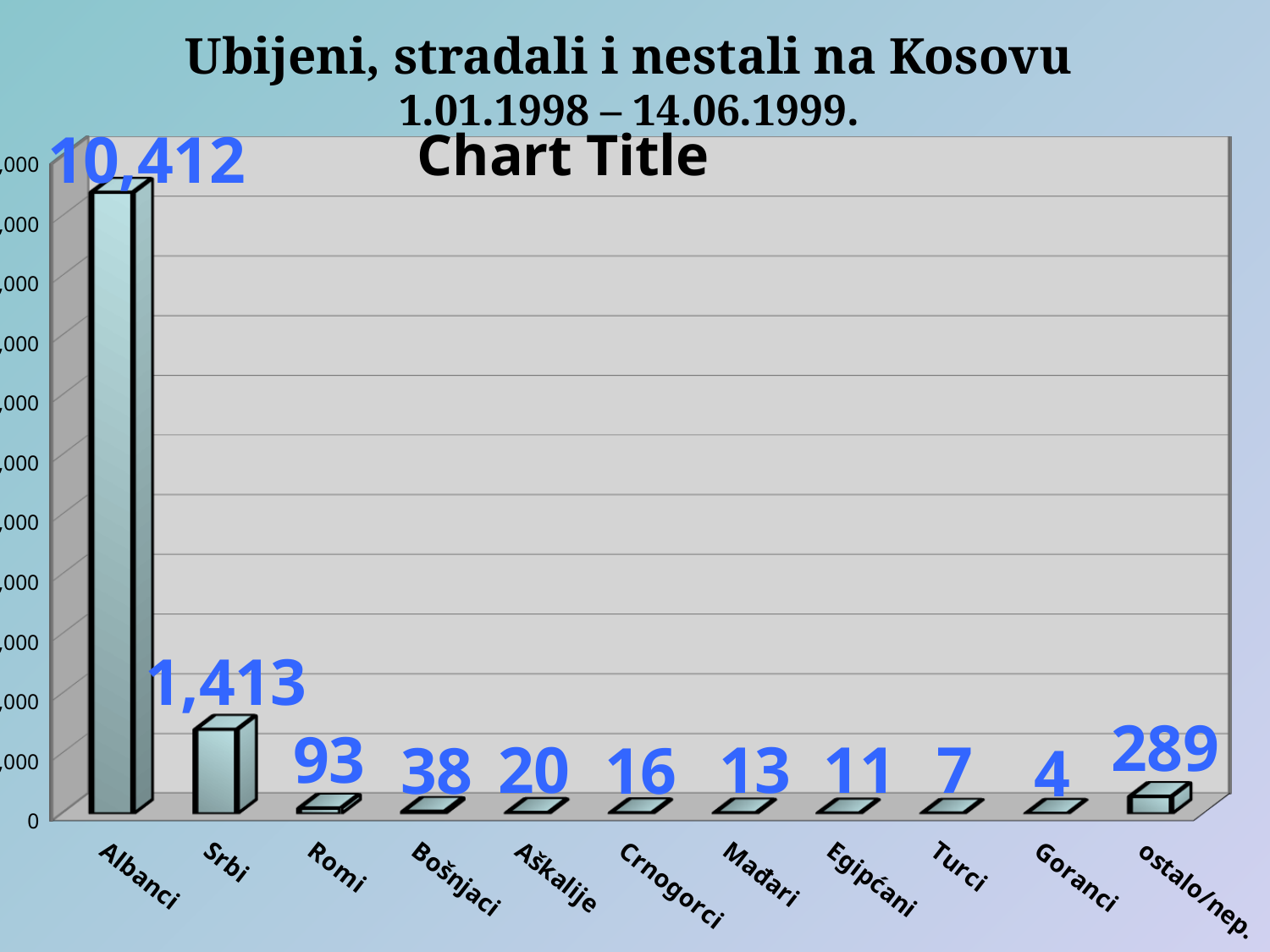
Which category has the lowest value? Goranci Which category has the highest value? Albanci How many categories are shown on the x axis? 11 What is the value for Srbi? 1,413 What is the value for Romi? 93 What kind of chart is shown on the slide? Bar chart Which is larger, the value for Romi or the value for ostalo/nep.? ostalo/nep. What is the difference between the values for Bošnjaci and Aškalije? 18 What is the value for Albanci? 10,412 What is the title printed inside the chart area? Chart Title What is the value for ostalo/nep.? 289 What is the difference between the values for Albanci and Srbi? 8,999